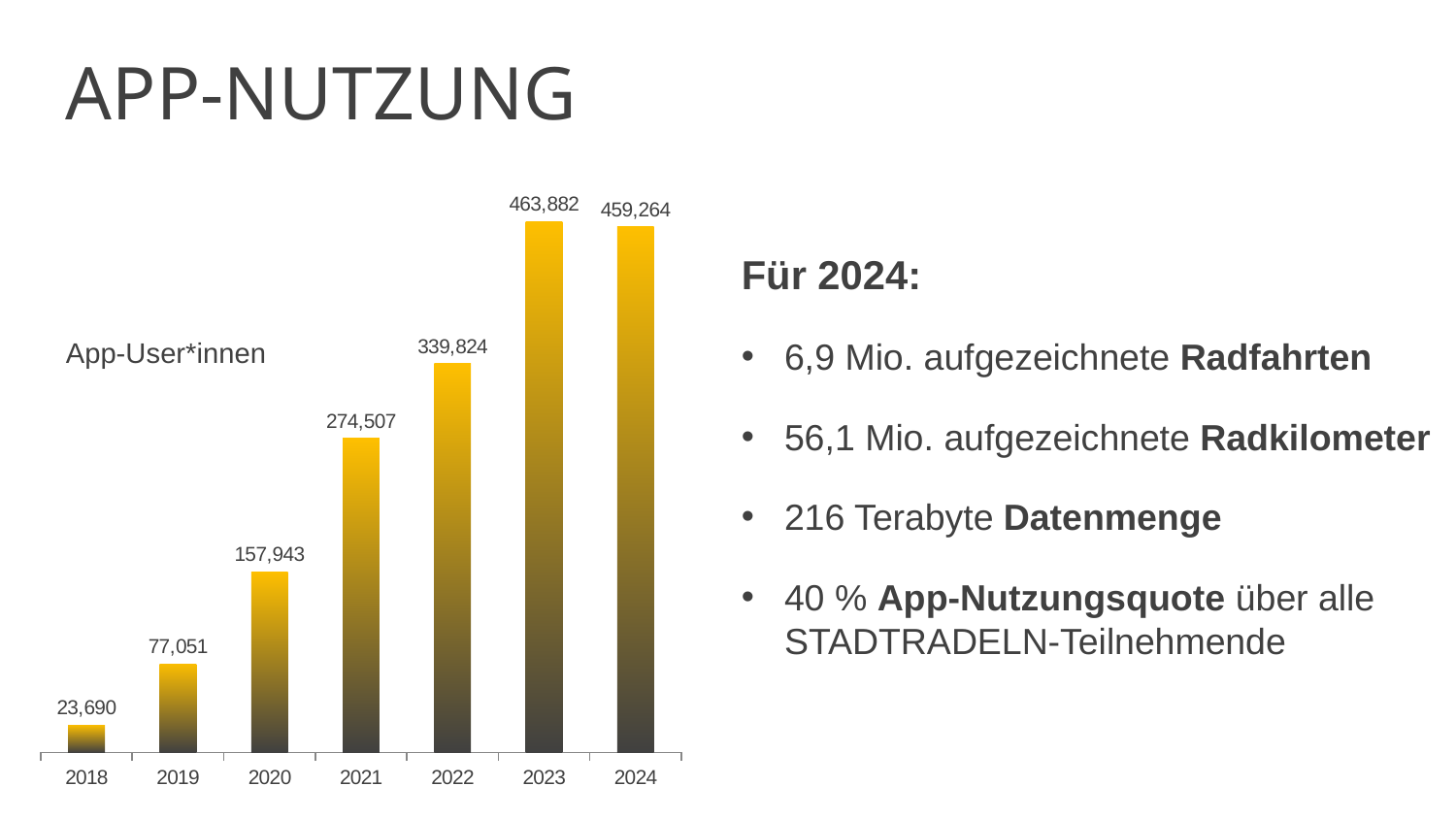
Which is larger, the value for 2022 or the value for 2021? 2022 What is the value for 2018 in the App-User*innen chart? 23,690 Do the values rise or fall from 2018 to 2023? rise How many years are shown on the x axis of the chart? 7 What is the value for 2021 in the App-User*innen chart? 274,507 What is the difference between the values for 2023 and 2024? 4,618 What is the value for 2024 in the App-User*innen chart? 459,264 What is the difference between the values for 2019 and 2018? 53,361 What is the value for 2020 in the App-User*innen chart? 157,943 Which year has the lowest number of App-User*innen? 2018 What kind of chart is shown on the slide? bar chart Which year has the highest number of App-User*innen? 2023